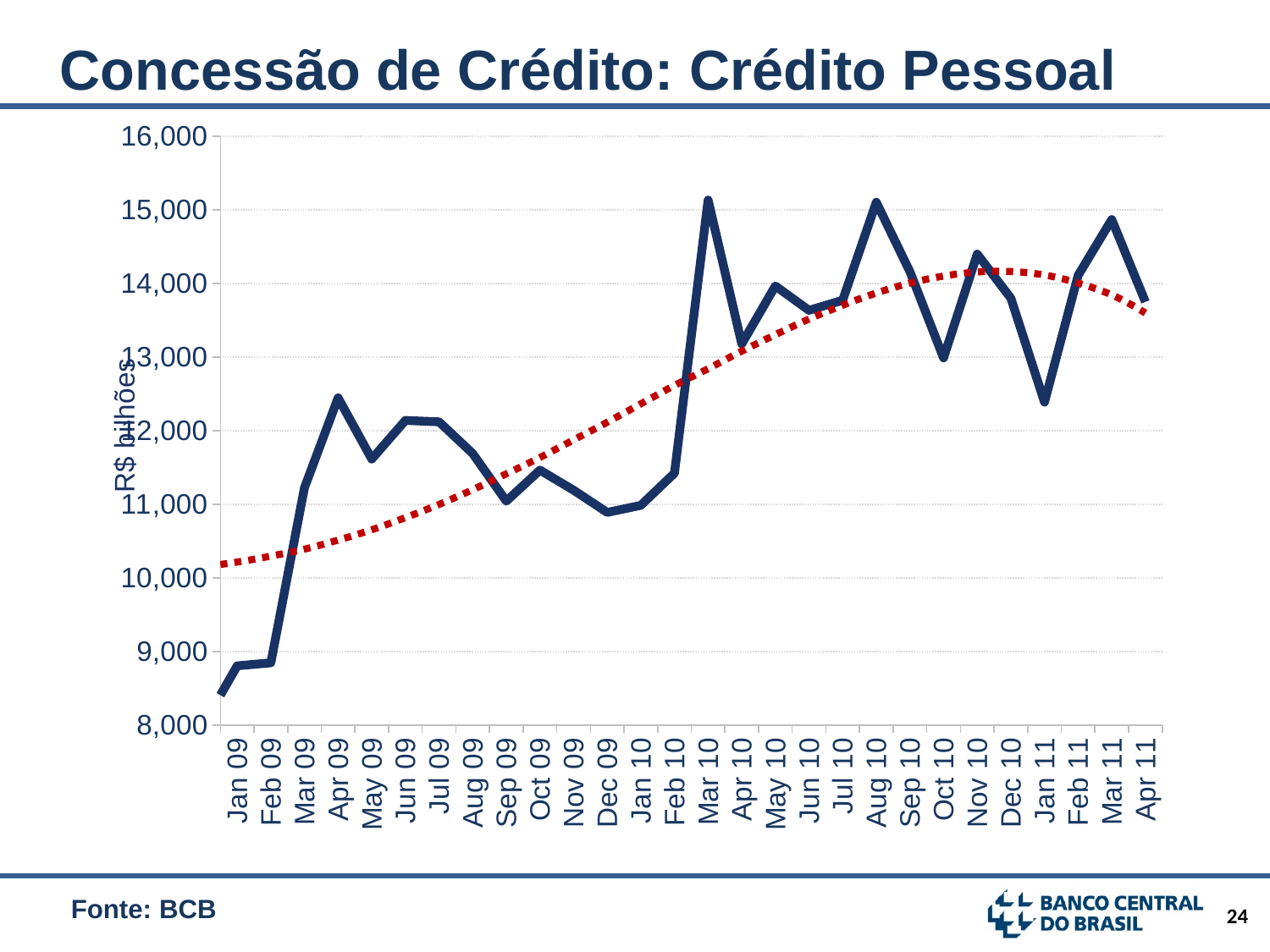
How many months are plotted along the x axis? 28 Is the value for Apr 09 greater or less than 12,000? greater Is the value for Jan 09 greater or less than 9,000? less Which month has the lowest value on the chart? Jan 09 Is the value for Mar 10 greater or less than 15,000? greater What unit label is shown on the y axis? R$ bilhões Which is larger, the value for Nov 10 or the value for Jan 11? Nov 10 Overall, do the values rise or fall from Jan 09 to Apr 11? rise What is the title of the chart on the slide? Concessão de Crédito: Crédito Pessoal What kind of chart is shown on the slide? line chart